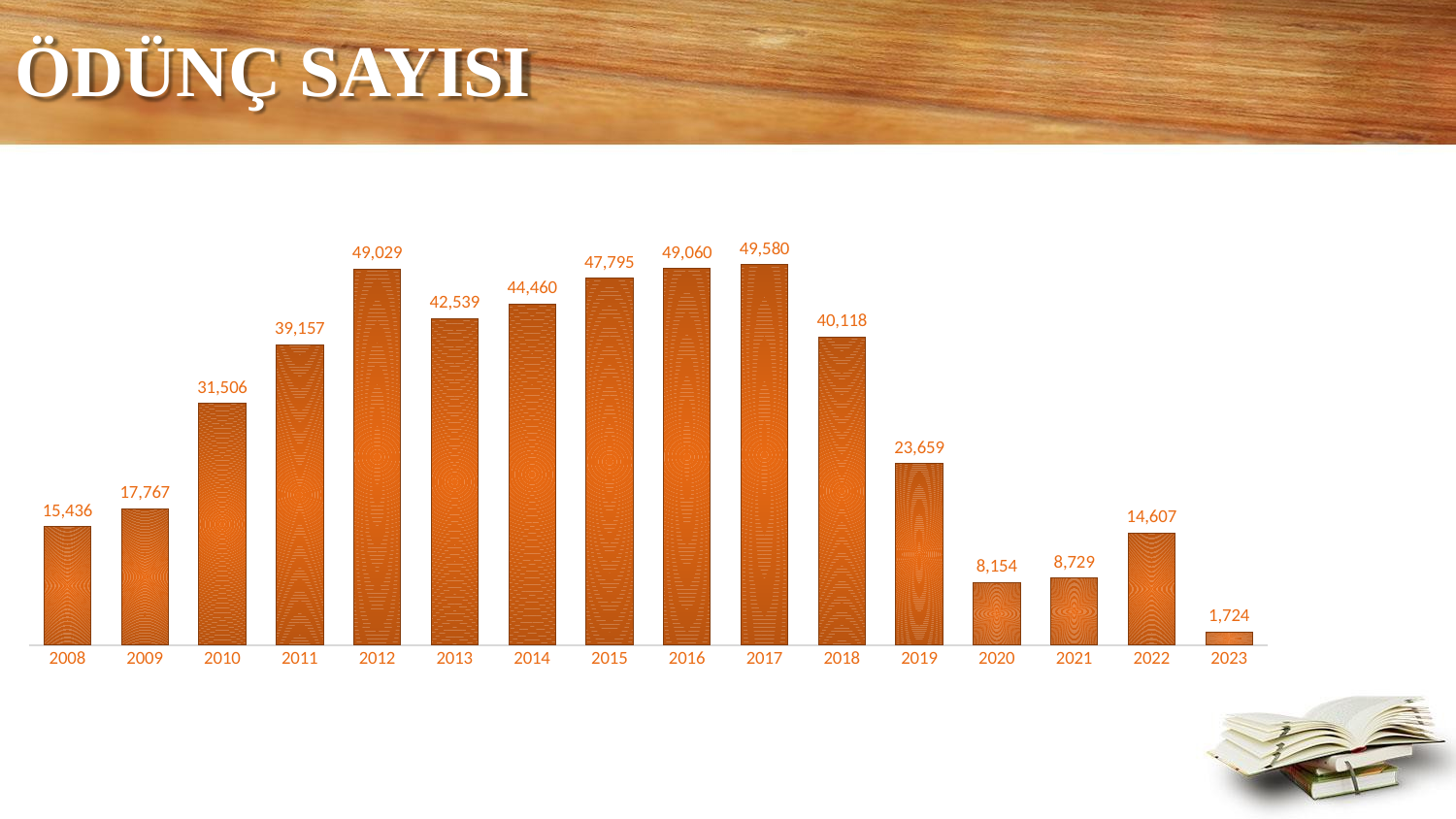
Which year has the highest value? 2017 What is the value for 2019? 23,659 What is the difference between the values for 2021 and 2020? 575 What is the difference between the values for 2017 and 2018? 9,462 Which year has the lowest value? 2023 What is the value for 2023? 1,724 Which is larger, the value for 2010 or the value for 2022? 2010 What is the title of the slide? ÖDÜNÇ SAYISI What is the value for 2012? 49,029 What kind of chart is shown on the slide? bar chart Do the values rise or fall from 2008 to 2012? rise How many years are shown on the x axis? 16